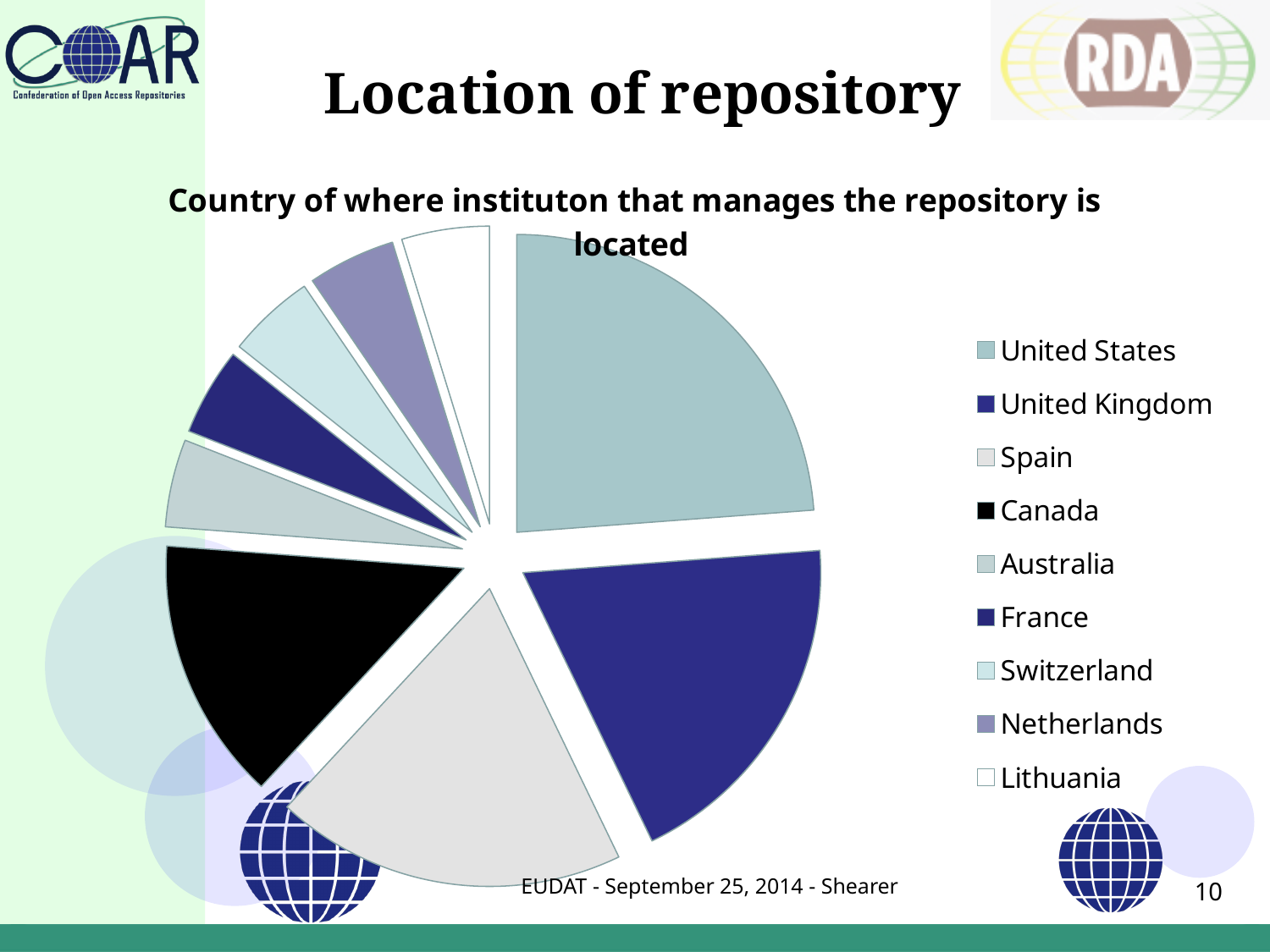
Which slice is larger, United States or Canada? United States How many countries does the legend list? 9 What is the title of the chart? Country of where instituton that manages the repository is located Which slice is larger, Spain or Switzerland? Spain Which slice is larger, United Kingdom or France? United Kingdom Which country is shown in black in the pie chart? Canada What kind of chart is shown on the slide? pie chart Which country has the largest slice of the pie? United States Which country is listed last in the legend? Lithuania How many slices does the pie chart have? 9